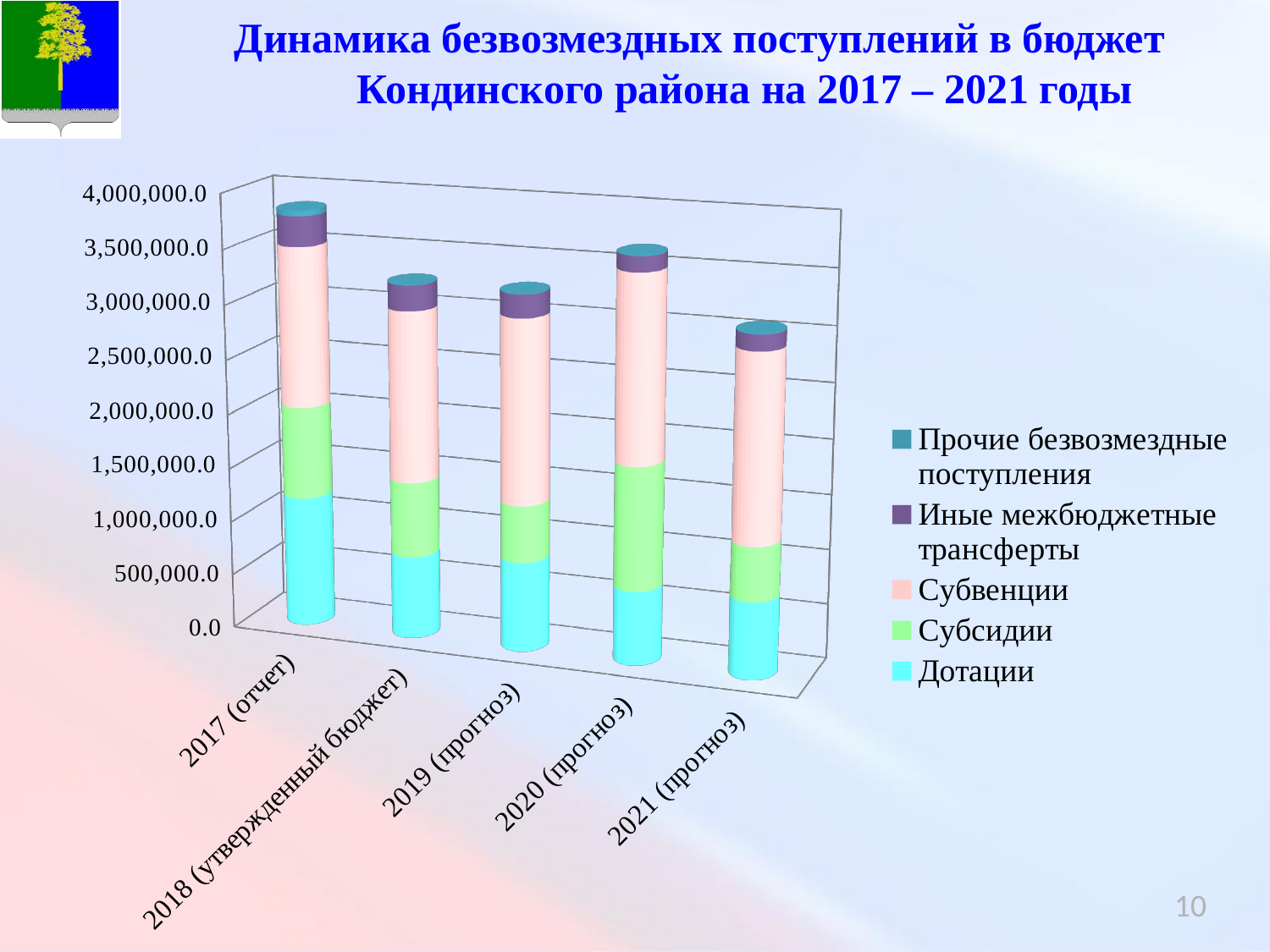
Is the total stacked bar for 2020 (прогноз) greater or less than 3,000,000.0? greater Which year has the shortest stacked bar in the chart? 2021 (прогноз) Which is larger, the total stacked bar for 2020 (прогноз) or for 2021 (прогноз)? 2020 (прогноз) Is the total stacked bar for 2017 (отчет) greater or less than 3,000,000.0? greater Which series forms the largest segment in every stacked bar of the chart? Субвенции What kind of chart is shown on the slide? stacked bar chart Which year has the tallest stacked bar in the chart? 2017 (отчет) What is the title of the chart on the slide? Динамика безвозмездных поступлений в бюджет Кондинского района на 2017 – 2021 годы How many series does the chart legend list? 5 How many categories (years) are shown on the x axis of the chart? 5